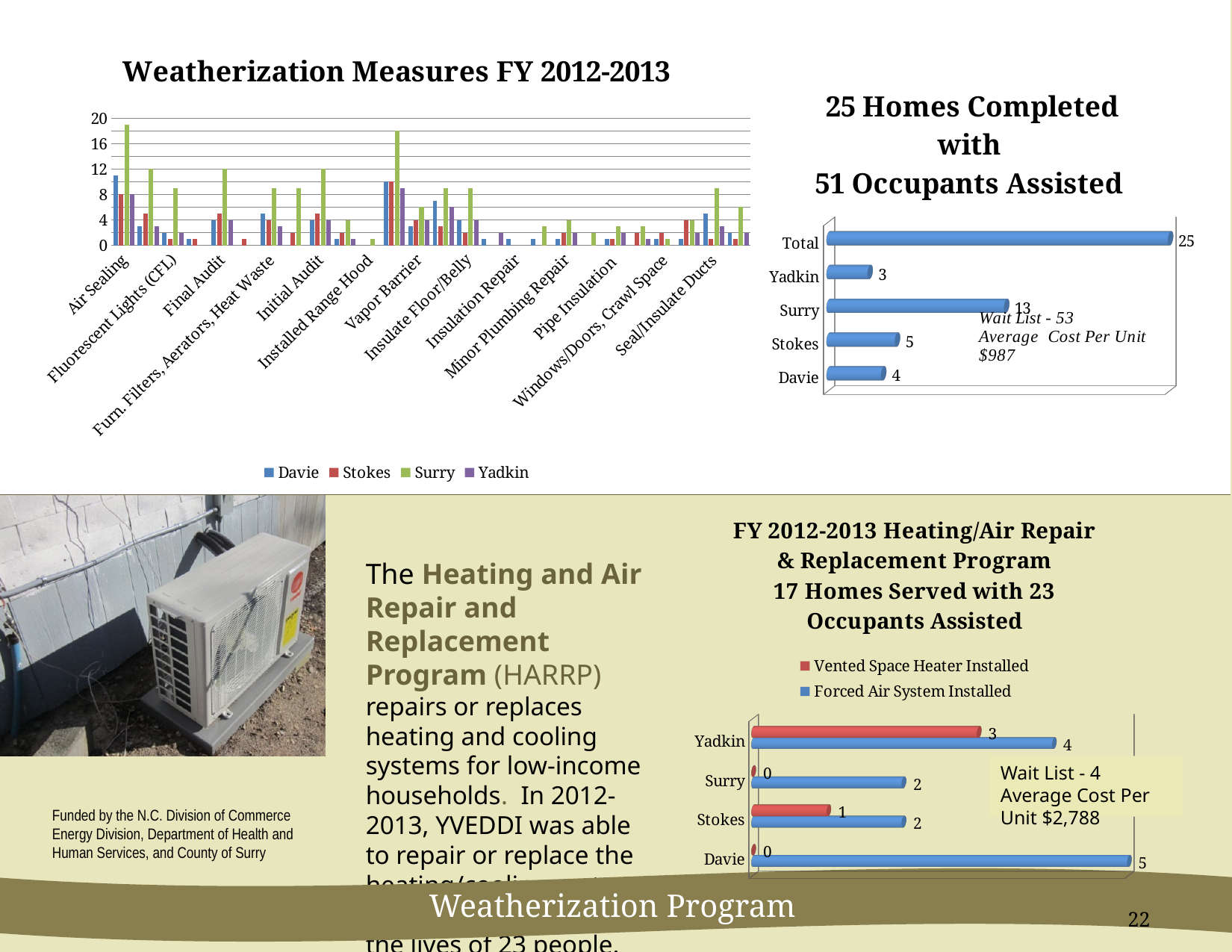
In the '25 Homes Completed with 51 Occupants Assisted' chart, what is the value for the Total bar? 25 In the 'Weatherization Measures FY 2012-2013' chart, how many series does the legend list? 4 What kind of chart is the 'Weatherization Measures FY 2012-2013' chart? bar chart In the '25 Homes Completed with 51 Occupants Assisted' chart, what is the value for Surry? 13 In the '25 Homes Completed with 51 Occupants Assisted' chart, what is the difference between the values for Surry and Stokes? 8 In the 'FY 2012-2013 Heating/Air Repair & Replacement Program' chart, what is the Vented Space Heater Installed value for Yadkin? 3 In the '25 Homes Completed with 51 Occupants Assisted' chart, which county has the lowest value? Yadkin In the 'FY 2012-2013 Heating/Air Repair & Replacement Program' chart, which is larger for Stokes: Vented Space Heater Installed or Forced Air System Installed? Forced Air System Installed In the 'Weatherization Measures FY 2012-2013' chart, is the Surry value for Air Sealing greater or less than 16? greater In the 'FY 2012-2013 Heating/Air Repair & Replacement Program' chart, how many series does the legend list? 2 In the 'FY 2012-2013 Heating/Air Repair & Replacement Program' chart, which county has the highest Forced Air System Installed value? Davie In the 'FY 2012-2013 Heating/Air Repair & Replacement Program' chart, what is the Forced Air System Installed value for Davie? 5